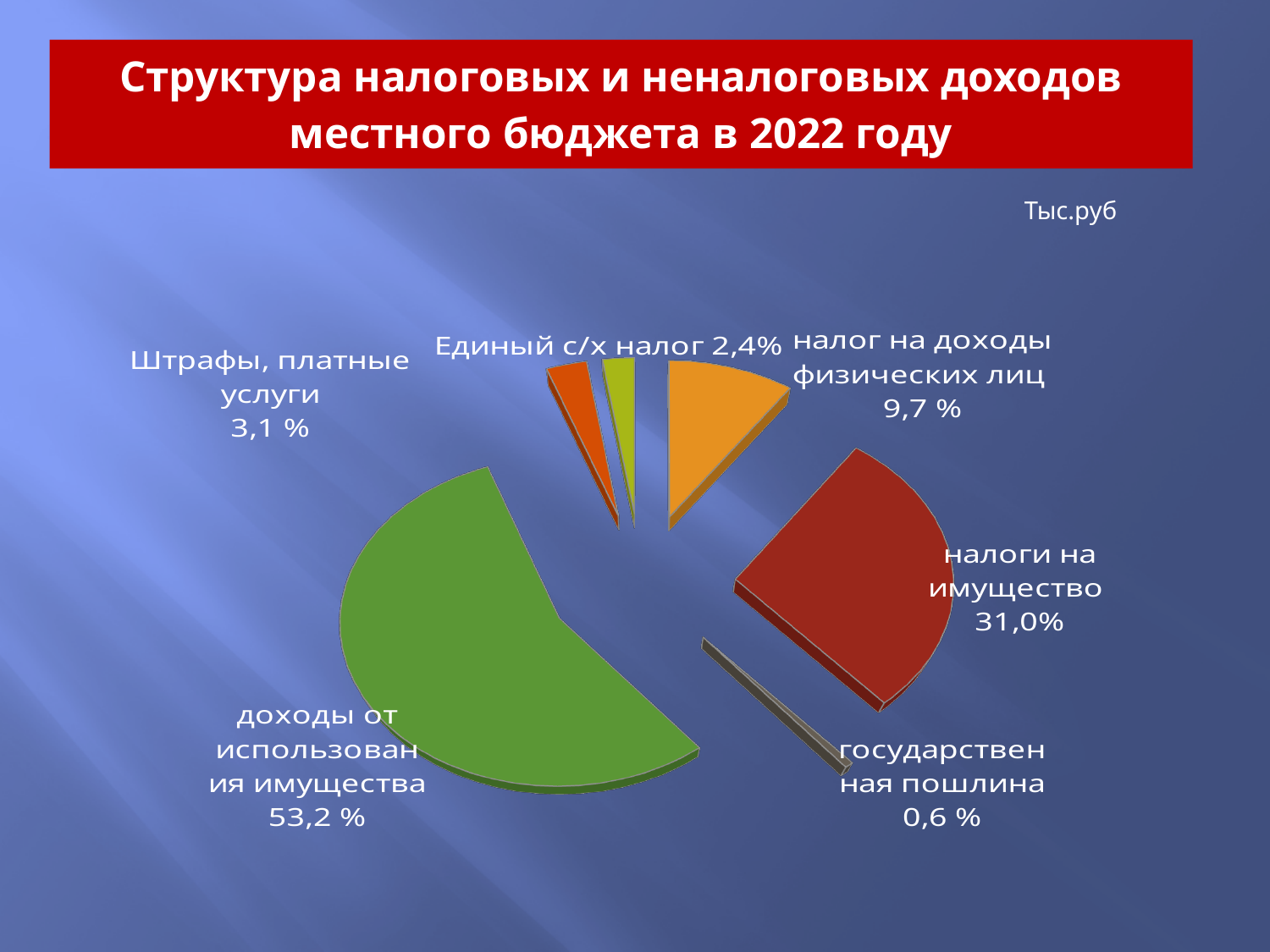
How many slices does the pie chart have? 6 What share is shown for «налог на доходы физических лиц»? 9,7 % Which is larger: the share for «налоги на имущество» or for «налог на доходы физических лиц»? налоги на имущество What type of chart is shown on the slide? Pie chart What share is shown for «Единый с/х налог»? 2,4% Which category has the largest slice of the pie? доходы от использования имущества Which category has the smallest slice of the pie? государственная пошлина What is the difference in percentage points between «доходы от использования имущества» and «налоги на имущество»? 22,2 What share is shown for «Штрафы, платные услуги»? 3,1 %